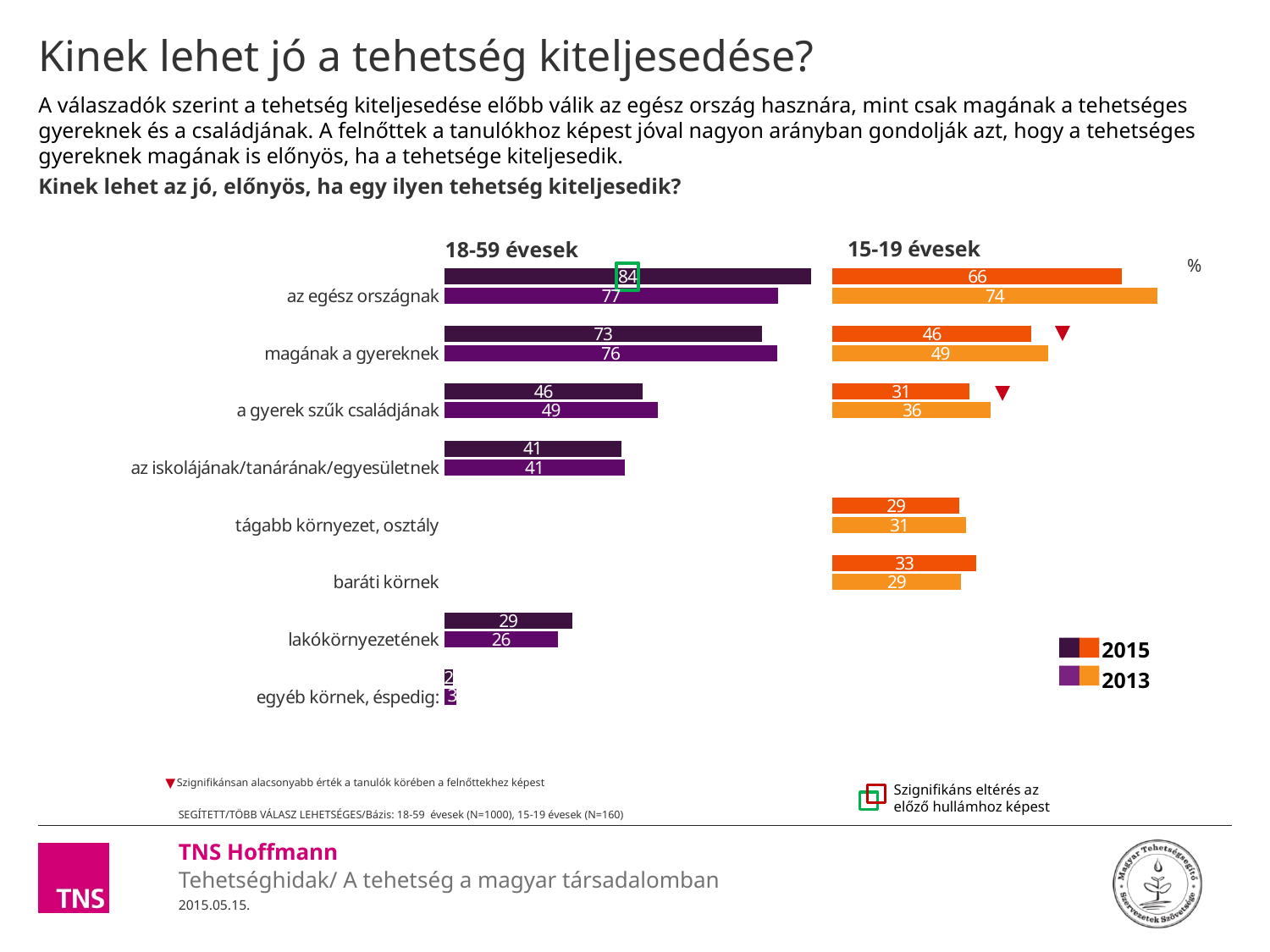
How many series does the legend list? 2 In the 18-59 évesek chart, which category has the lowest 2013 value? egyéb körnek, éspedig: In the 15-19 évesek chart, what is the 2013 value for 'az egész országnak'? 74 In the 18-59 évesek chart, what is the 2013 value for 'magának a gyereknek'? 76 In the 18-59 évesek chart, which category has the highest 2015 value? az egész országnak In the 15-19 évesek chart, how many categories have bars plotted? 5 What kind of chart is used on this slide? bar chart In the 15-19 évesek chart, which is larger for 'a gyerek szűk családjának': the 2015 value or the 2013 value? 2013 In the 15-19 évesek chart, what is the difference between the 2013 and 2015 values for 'az egész országnak'? 8 In the 18-59 évesek chart, what is the 2015 value for 'az egész országnak'? 84 In the 18-59 évesek chart, what is the difference between the 2015 and 2013 values for 'az egész országnak'? 7 In the 15-19 évesek chart, what is the 2015 value for 'baráti körnek'? 33